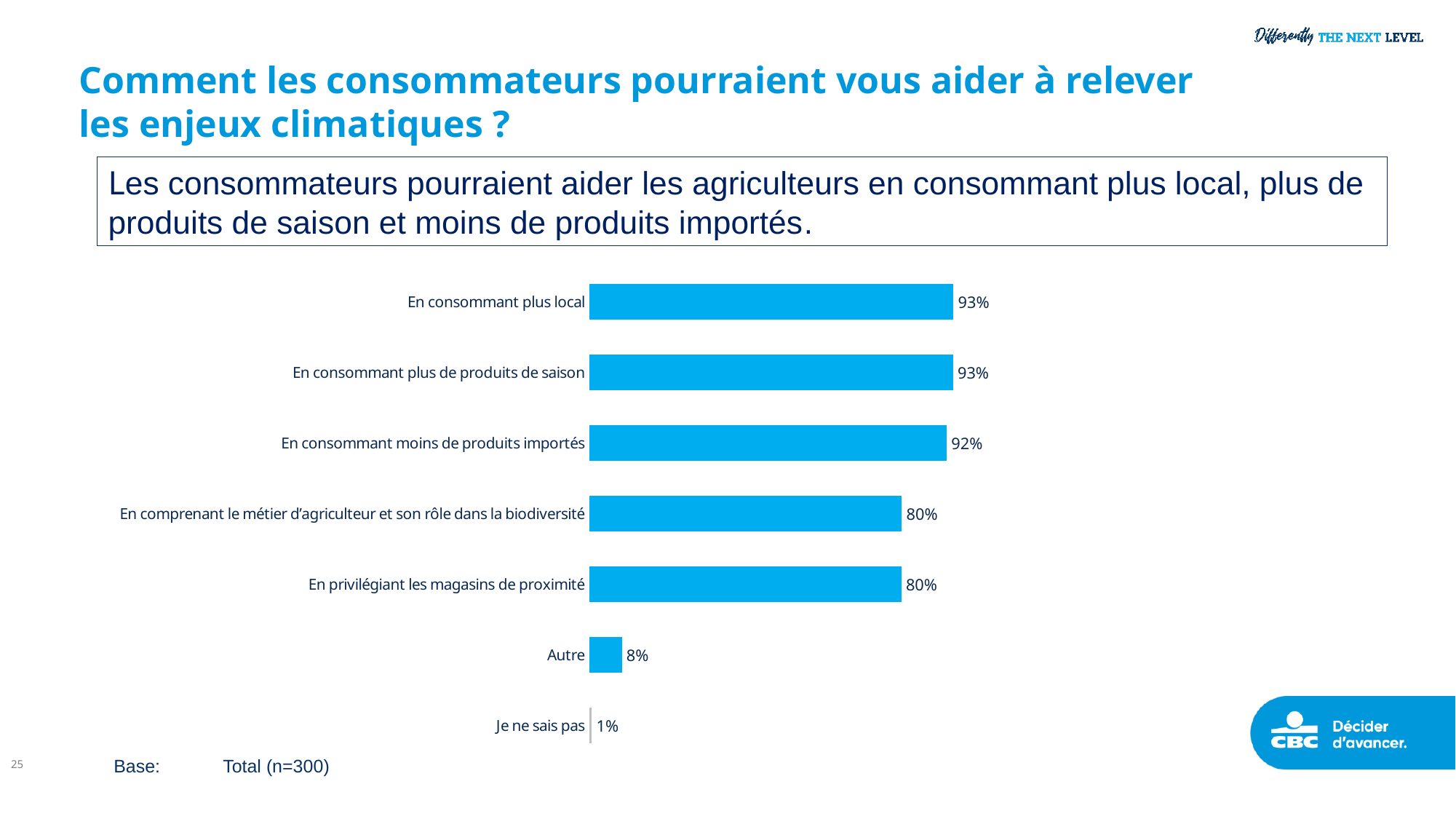
What kind of chart is shown on the slide? Bar chart What is the value for "Je ne sais pas"? 1% How many categories are shown in the chart? 7 What is the value for "En consommant plus local"? 93% What is the difference between "En consommant plus local" and "En comprenant le métier d'agriculteur et son rôle dans la biodiversité"? 13% Which category has the lowest value? Je ne sais pas What is the value for "Autre"? 8% What is the base (sample size) stated below the chart? Total (n=300) Which is larger: "En consommant moins de produits importés" or "En privilégiant les magasins de proximité"? En consommant moins de produits importés What is the value for "En privilégiant les magasins de proximité"? 80% What is the value for "En consommant moins de produits importés"? 92% What is the difference between "Autre" and "Je ne sais pas"? 7%